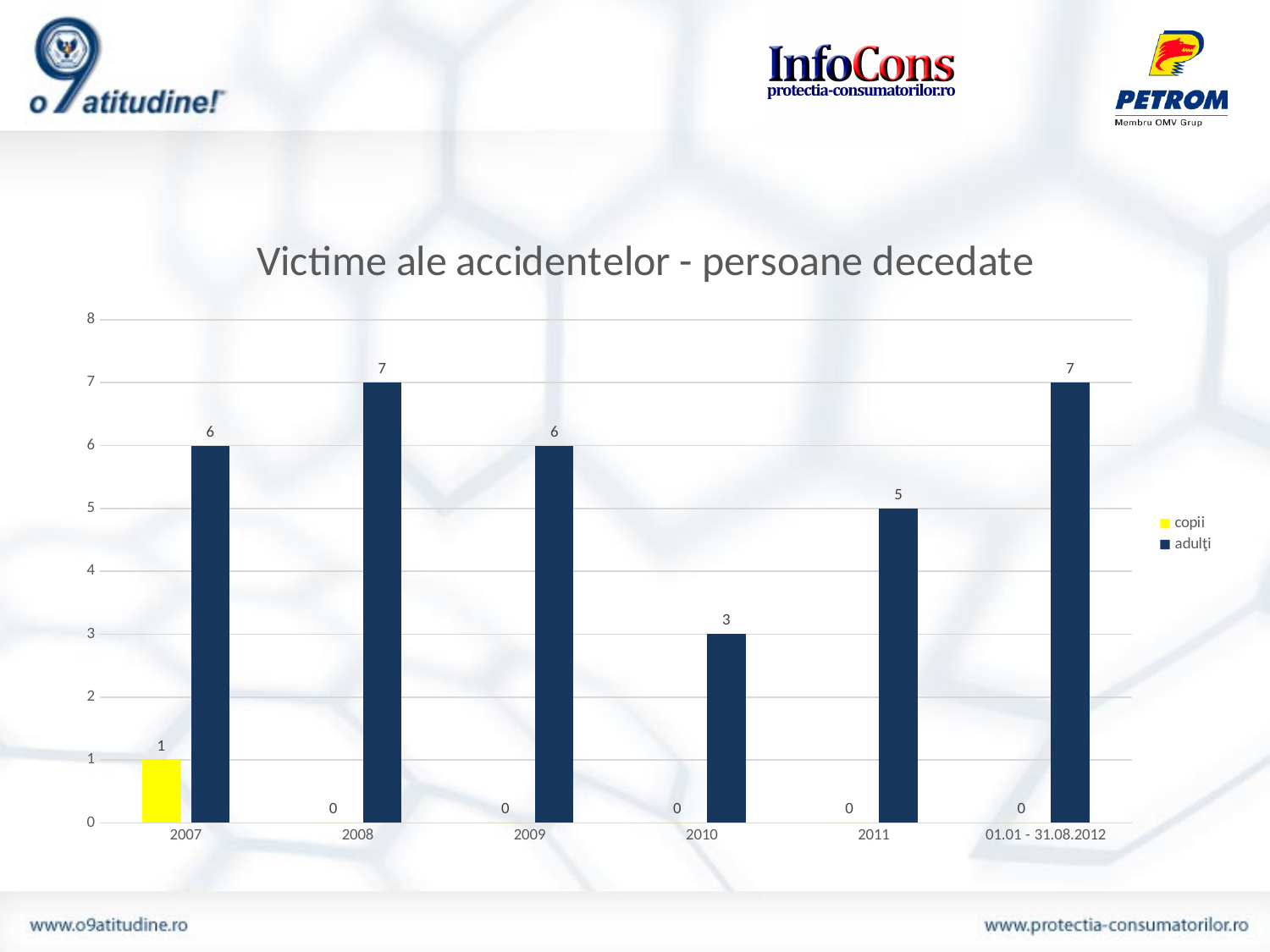
What is the difference between the adulţi values for 2009 and 2010? 3 Which category has the lowest value for adulţi? 2010 What is the value for adulţi in 2008? 7 What is the value for adulţi in 2011? 5 Which is larger, the adulţi value for 2011 or for 2009? 2009 What kind of chart is shown on the slide? bar chart How many categories are shown on the x axis? 6 What colour represents the copii series? yellow What is the value for adulţi in 2010? 3 What is the value for copii in 2007? 1 What is the title of the chart? Victime ale accidentelor - persoane decedate How many series does the legend list? 2